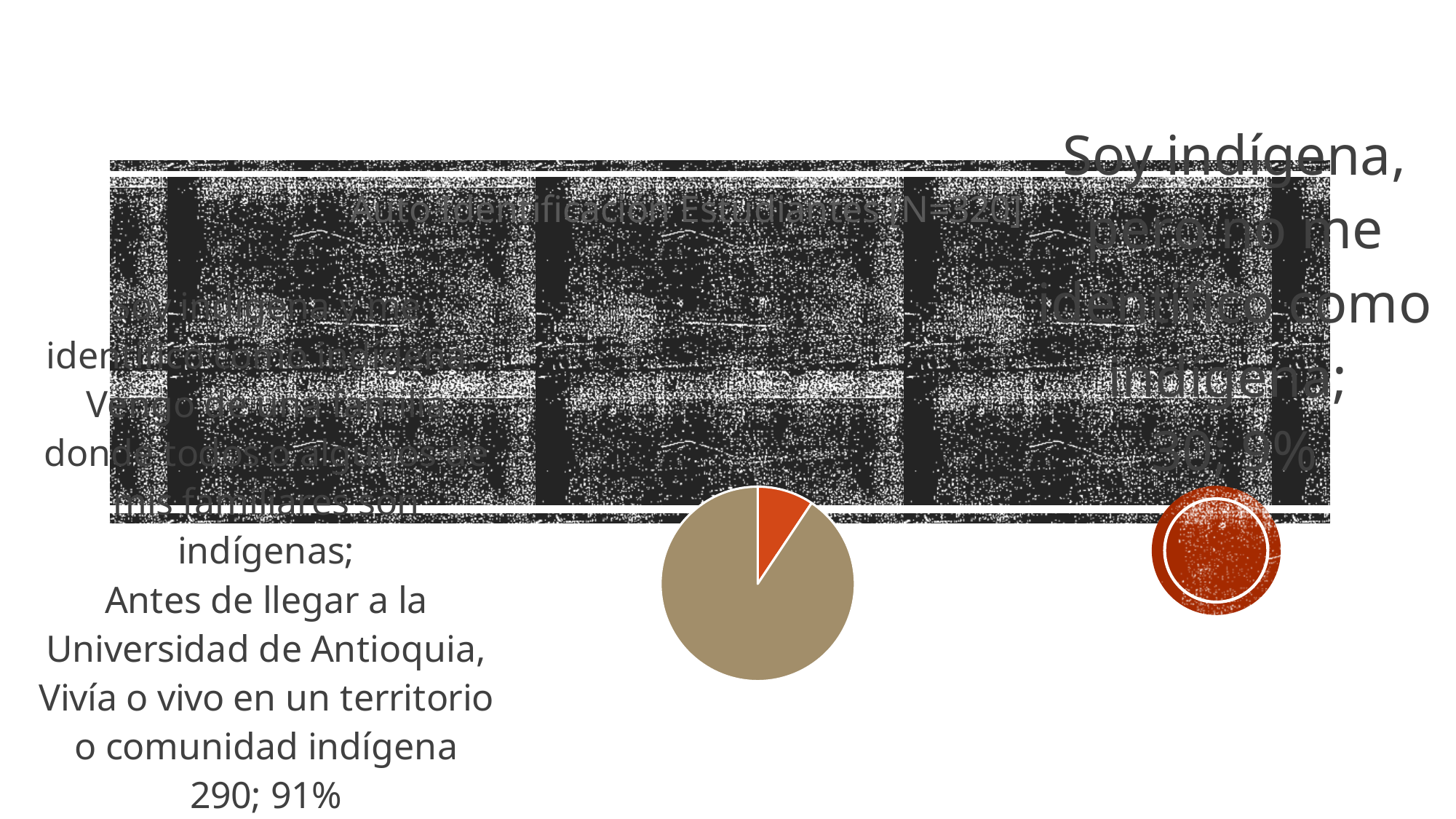
What kind of chart is shown on the slide? pie chart What is the total of the two slice counts in the pie chart? 320 How many slices does the pie chart have? 2 Which is larger: the slice with 30 students or the slice with 290 students? the slice with 290 students What is the title of the pie chart? Auto Identificación Estudiantes [N=320] What is the difference between the counts of the two slices (290 and 30)? 260 What is the count shown for the slice describing students who identify as indigenous, come from an indigenous family and lived in an indigenous territory? 290 Which slice of the pie chart is the smallest? Soy indígena, pero no me identifico como indígena What percentage is shown for the slice 'Soy indígena, pero no me identifico como indígena'? 9% What percentage of the pie is taken by the slice with the count 290? 91% What is the count shown for the slice 'Soy indígena, pero no me identifico como indígena'? 30